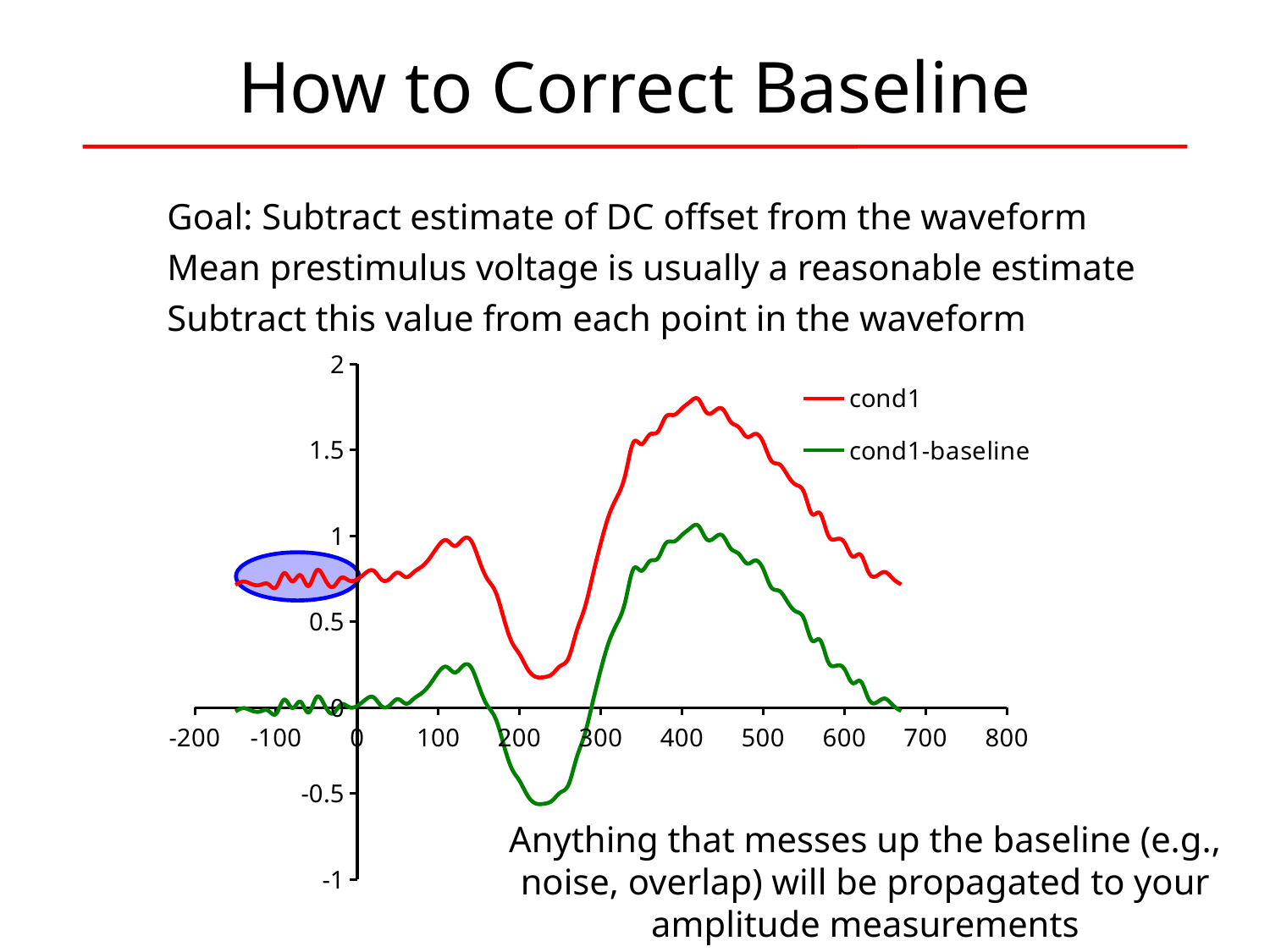
Does the cond1-baseline line rise or fall between x = 500 and x = 600? fall What are the two series named in the legend? cond1 and cond1-baseline What kind of chart is shown on the slide? line chart What colour is the cond1-baseline line? green Is the lowest value of the cond1-baseline line greater or less than 0? less At x = 400, which series has the larger value, cond1 or cond1-baseline? cond1 Which series reaches the higher peak value? cond1 Is the peak value of the cond1 line greater or less than 1.5? greater Is the value of cond1 at x = 0 greater or less than 0.5? greater How many series does the legend list? 2 Does the cond1 line rise or fall between x = 300 and x = 400? rise